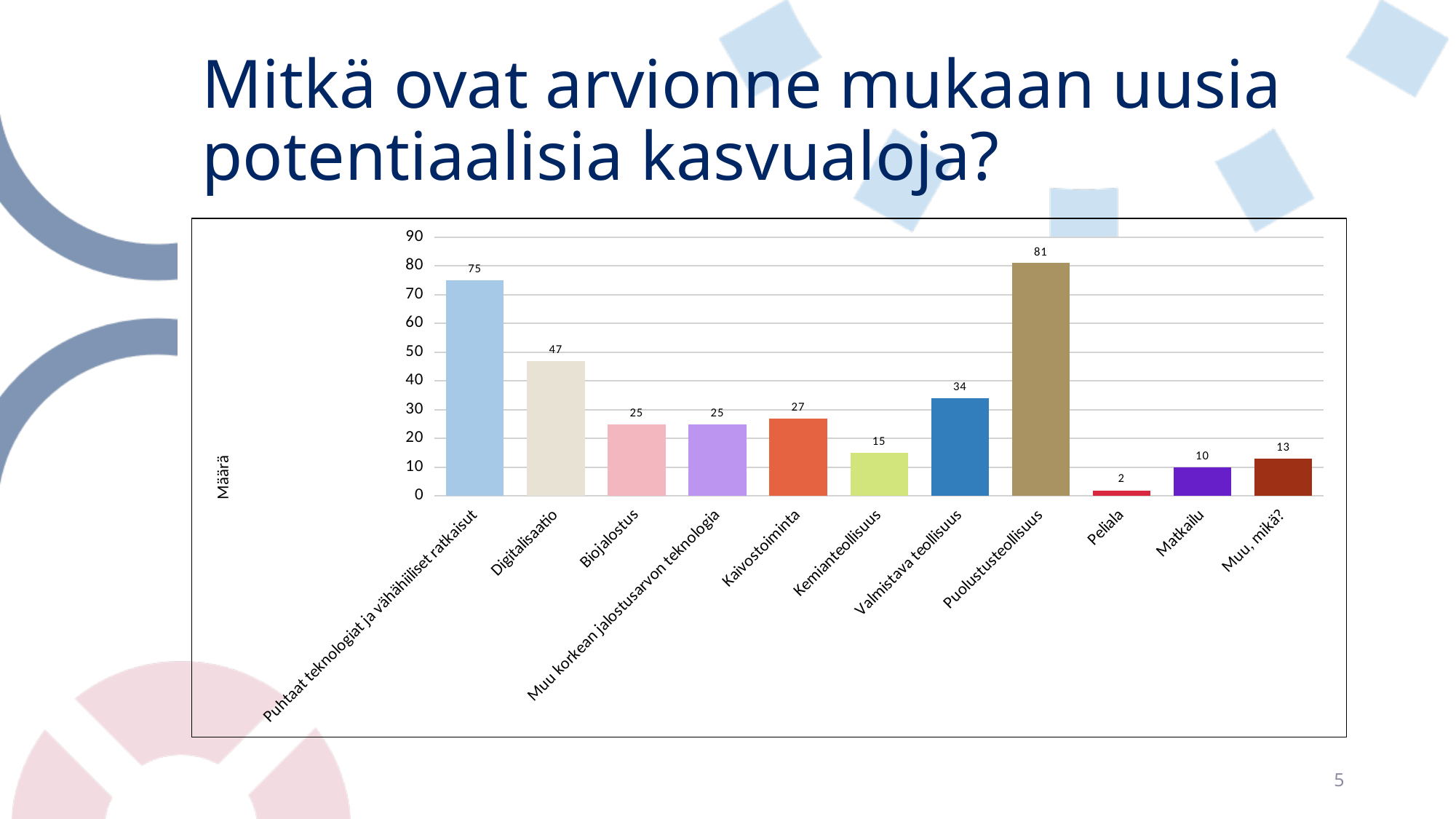
What is the value for Digitalisaatio? 47 Is the value for Digitalisaatio greater or less than 50? less Which category has the lowest value? Peliala What is the value for Puolustusteollisuus? 81 What is the label on the vertical axis of the chart? Määrä What is the difference between the values for Matkailu and Muu, mikä? 3 Which category has the highest value? Puolustusteollisuus What kind of chart is shown on the slide? bar chart What is the difference between the values for Puolustusteollisuus and Puhtaat teknologiat ja vähähiiliset ratkaisut? 6 What is the value for Kemianteollisuus? 15 How many categories are shown in the chart? 11 Which is larger, the value for Valmistava teollisuus or the value for Kaivostoiminta? Valmistava teollisuus